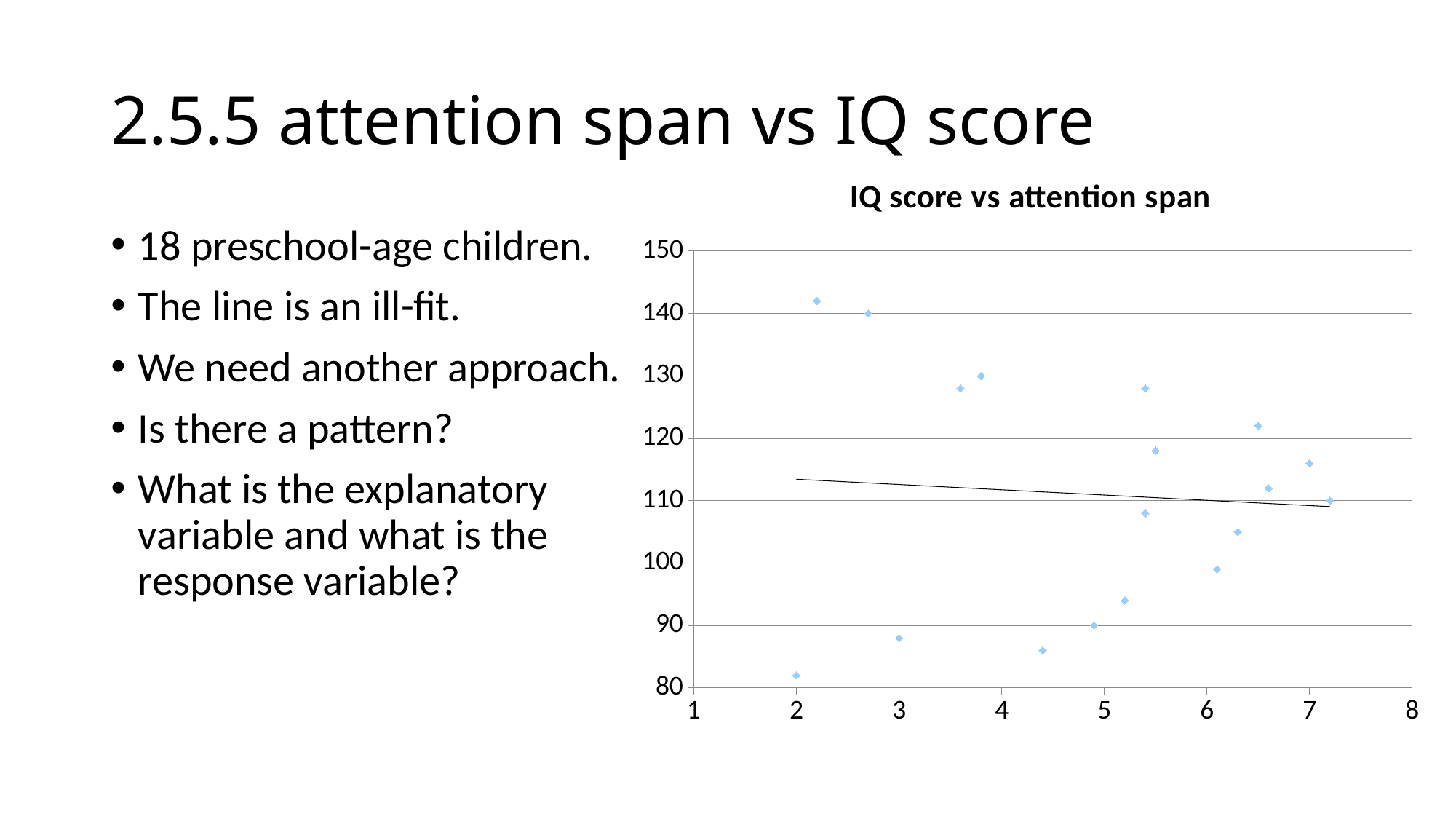
What is the highest value shown on the vertical axis of the chart? 150 What kind of chart is shown on the slide? Scatter plot What is the title of the chart? IQ score vs attention span How many plotted points have an IQ score below 90? 3 Is the IQ score of the point at attention span 7 greater or less than 110? greater Is the IQ score of the point at attention span 4.4 greater or less than 90? less Is the IQ score of the point at attention span 2 greater or less than 90? less Which has the higher IQ score: the point at attention span 2 or the point at attention span 2.2? The point at attention span 2.2 Does the fitted line in the chart rise or fall as attention span increases along the x axis? Falls How many data points are plotted in the chart? 18